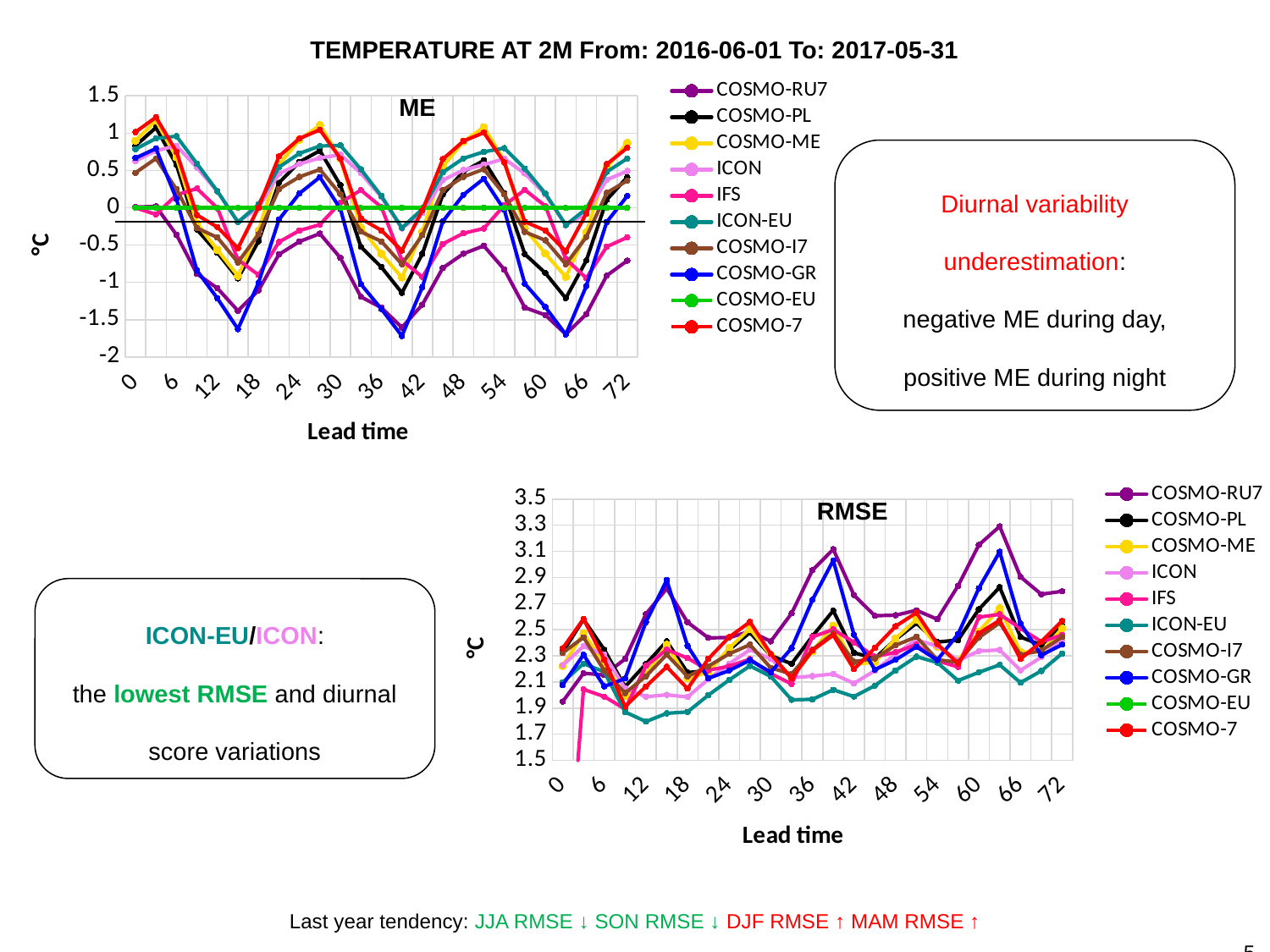
In the ME chart, is the value for COSMO-7 at lead time 3 greater or less than 1? greater What is the title printed above both charts? TEMPERATURE AT 2M From: 2016-06-01 To: 2017-05-31 In the ME chart, is the value for COSMO-RU7 at lead time 15 greater or less than -1? less How many lead time tick labels are shown on the x axis of the ME chart? 13 What is the x-axis label of the RMSE chart? Lead time In the RMSE chart, at lead time 63, which is larger: COSMO-RU7 or ICON-EU? COSMO-RU7 How many series does the legend of the RMSE chart list? 10 In the RMSE chart, is the value for ICON-EU at lead time 15 greater or less than 1.9? less In the RMSE chart, which series has the lowest values overall? ICON-EU What kind of chart is the ME chart? line chart In the RMSE chart, which series reaches the highest value? COSMO-RU7